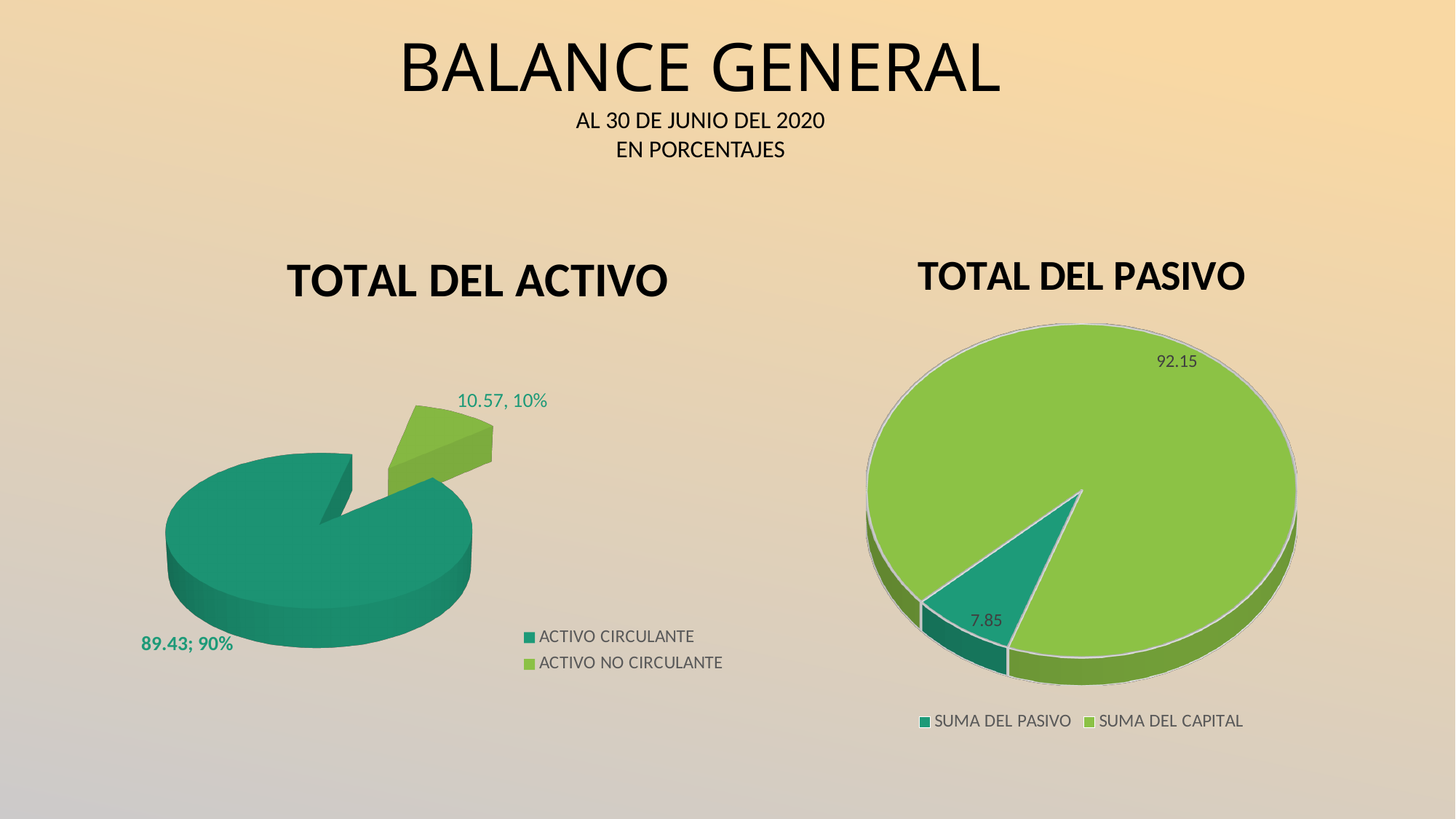
In the 'TOTAL DEL ACTIVO' chart, what percentage share is labelled for ACTIVO CIRCULANTE? 90% In the 'TOTAL DEL ACTIVO' chart, what value is shown for ACTIVO CIRCULANTE? 89.43 In the 'TOTAL DEL PASIVO' chart, what is the difference between the SUMA DEL CAPITAL and SUMA DEL PASIVO values? 84.30 What type of chart is the 'TOTAL DEL PASIVO' chart? Pie chart In the 'TOTAL DEL ACTIVO' chart, which slice is the smallest? ACTIVO NO CIRCULANTE In the 'TOTAL DEL PASIVO' chart, how many entries does the legend list? 2 In the 'TOTAL DEL PASIVO' chart, what value is shown for SUMA DEL PASIVO? 7.85 In the 'TOTAL DEL PASIVO' chart, what value is shown for SUMA DEL CAPITAL? 92.15 In the 'TOTAL DEL PASIVO' chart, which slice is the largest? SUMA DEL CAPITAL In the 'TOTAL DEL ACTIVO' chart, what value is shown for ACTIVO NO CIRCULANTE? 10.57 In the 'TOTAL DEL ACTIVO' chart, how many slices does the pie have? 2 In the 'TOTAL DEL ACTIVO' chart, what percentage share is labelled for ACTIVO NO CIRCULANTE? 10%